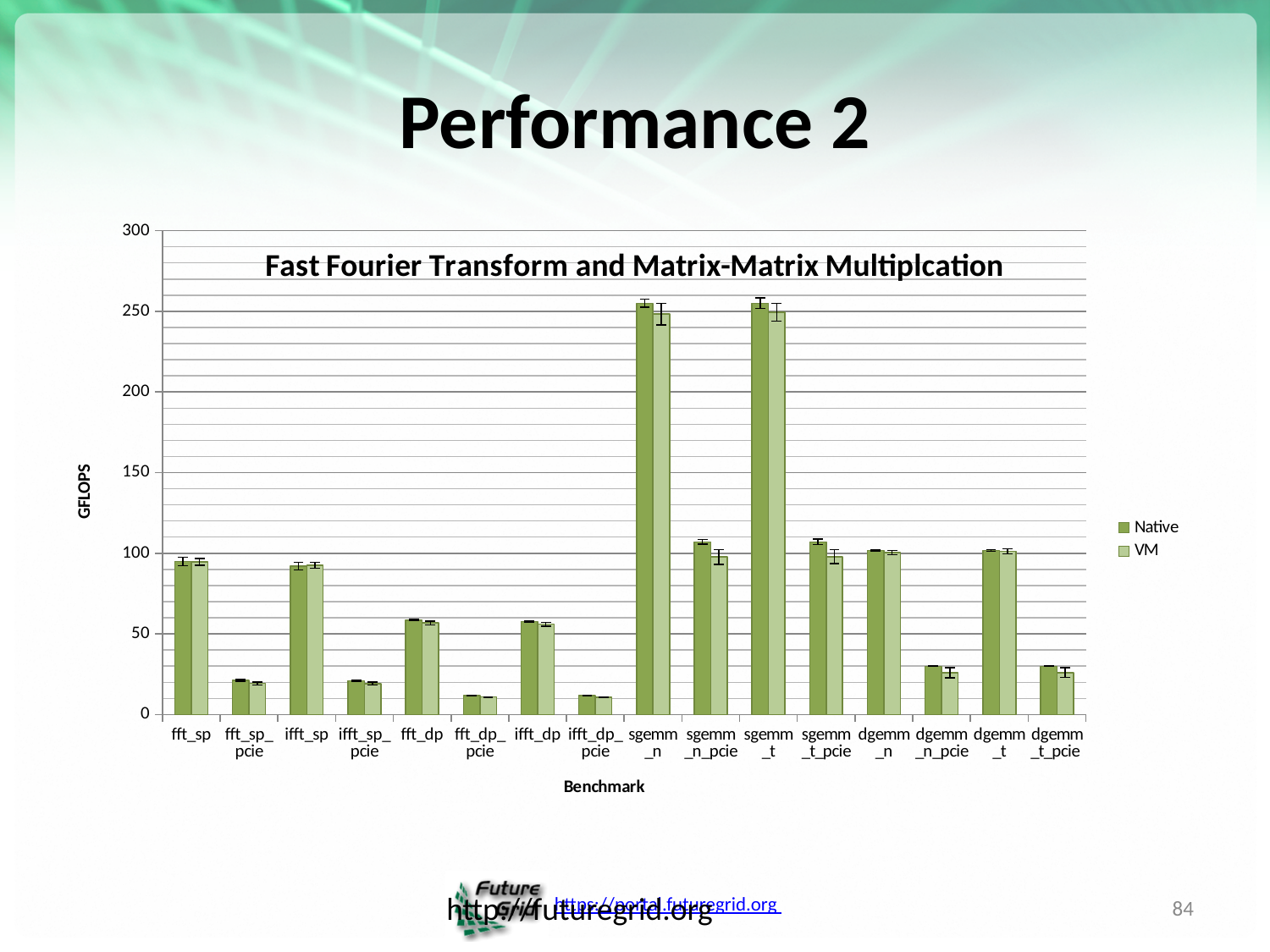
Is the Native value for sgemm_n greater or less than 250? greater Which has the larger Native value, sgemm_n or fft_sp? sgemm_n What kind of chart is shown on the slide? bar chart Is the VM value for dgemm_n_pcie greater or less than 50? less How many series does the legend list? 2 Is the Native value for fft_sp greater or less than 100? less What is the label of the y axis? GFLOPS How many benchmark categories are shown on the x axis? 16 Which has the larger Native value, fft_dp or fft_dp_pcie? fft_dp What is the title of the chart? Fast Fourier Transform and Matrix-Matrix Multiplcation